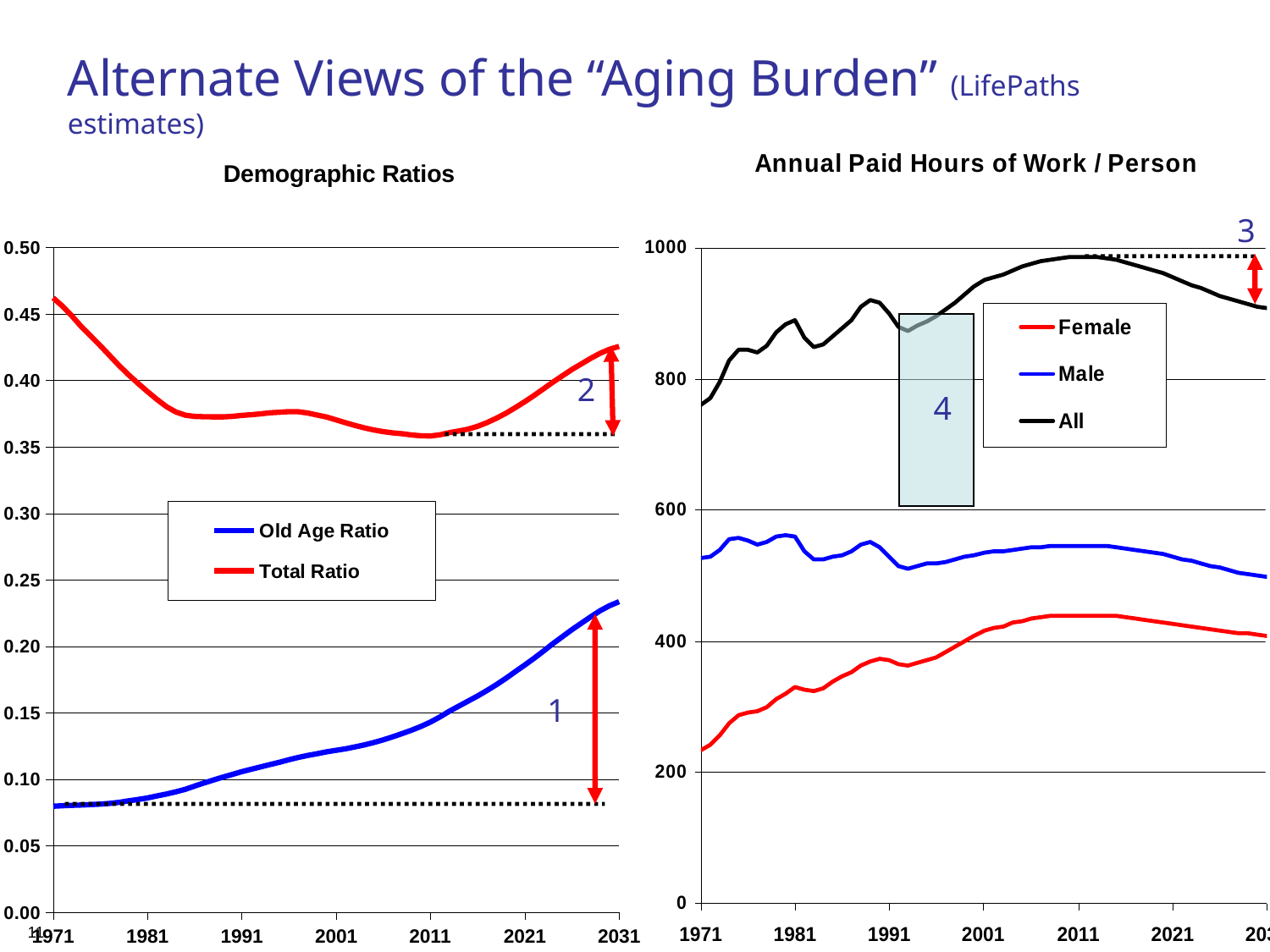
In the "Demographic Ratios" chart, does the Old Age Ratio rise or fall from 1971 to 2031? rise In the "Annual Paid Hours of Work / Person" chart, what colour is the line for the All series? black In the "Demographic Ratios" chart, is the Old Age Ratio in 1971 greater or less than 0.10? less In the "Demographic Ratios" chart, is the Total Ratio in 1971 greater or less than 0.45? greater In the "Annual Paid Hours of Work / Person" chart, which series is higher in 2031, Male or Female? Male How many series does the legend of the "Annual Paid Hours of Work / Person" chart list? 3 In the "Annual Paid Hours of Work / Person" chart, is the Female value in 1971 greater or less than 200? greater In the "Demographic Ratios" chart, which series is higher in 2031, Old Age Ratio or Total Ratio? Total Ratio What kind of chart is the "Demographic Ratios" chart? line chart How many series does the legend of the "Demographic Ratios" chart list? 2 In the "Annual Paid Hours of Work / Person" chart, does the Female series rise or fall from 1971 to 2011? rise